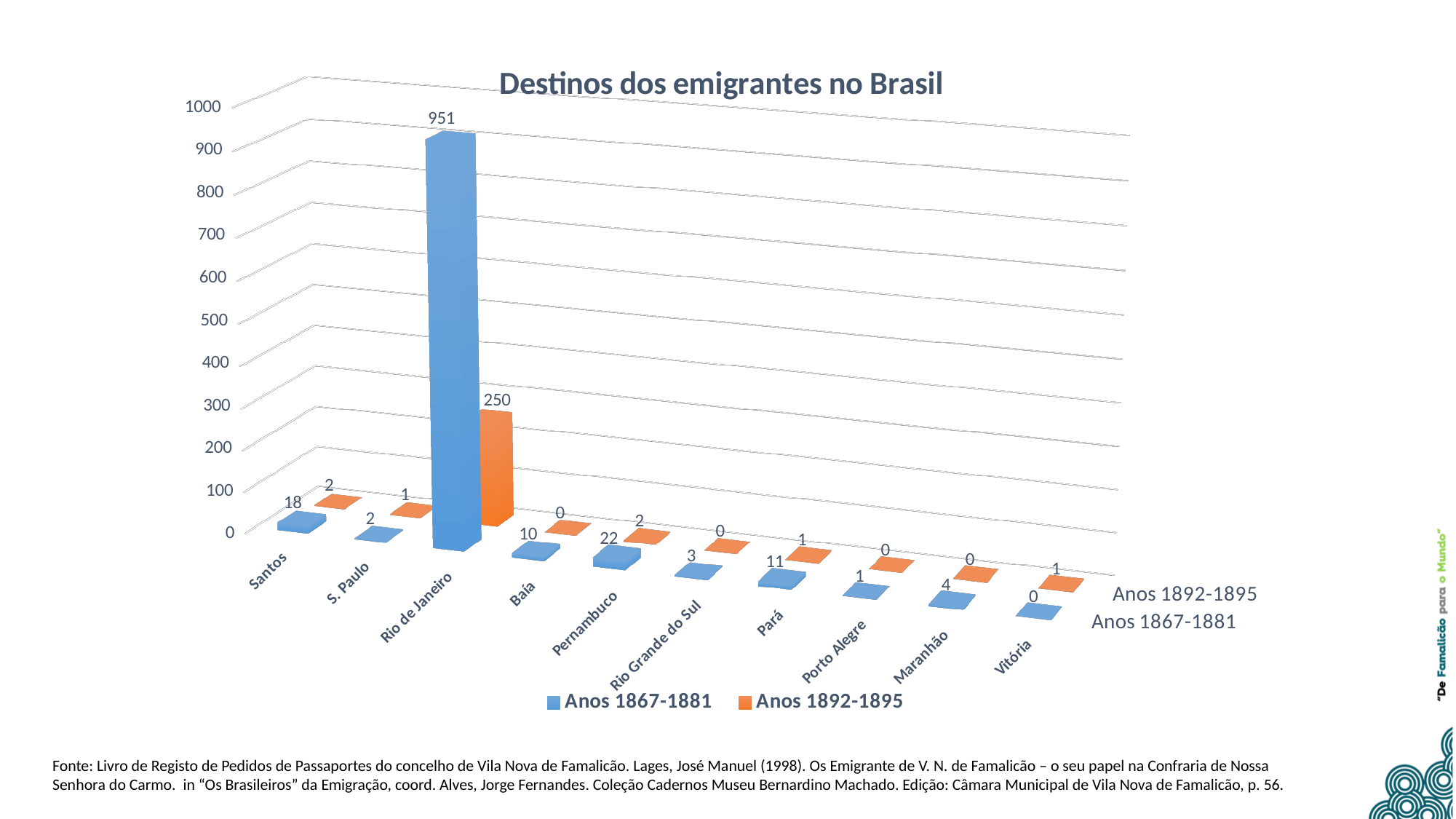
What is the title of the chart? Destinos dos emigrantes no Brasil Which destination has the highest value in the Anos 1867-1881 series? Rio de Janeiro What is the value for Pernambuco in the Anos 1867-1881 series? 22 How many destinations are shown on the x axis? 10 What is the value for Rio de Janeiro in the Anos 1867-1881 series? 951 What is the value for Rio de Janeiro in the Anos 1892-1895 series? 250 What kind of chart is shown on the slide? Bar chart Is the value for Rio de Janeiro in the Anos 1867-1881 series greater or less than 900? greater Which is larger in the Anos 1867-1881 series: Santos or Pernambuco? Pernambuco How many series does the legend list? 2 What is the value for Santos in the Anos 1892-1895 series? 2 What is the difference between the Anos 1867-1881 and Anos 1892-1895 values for Rio de Janeiro? 701